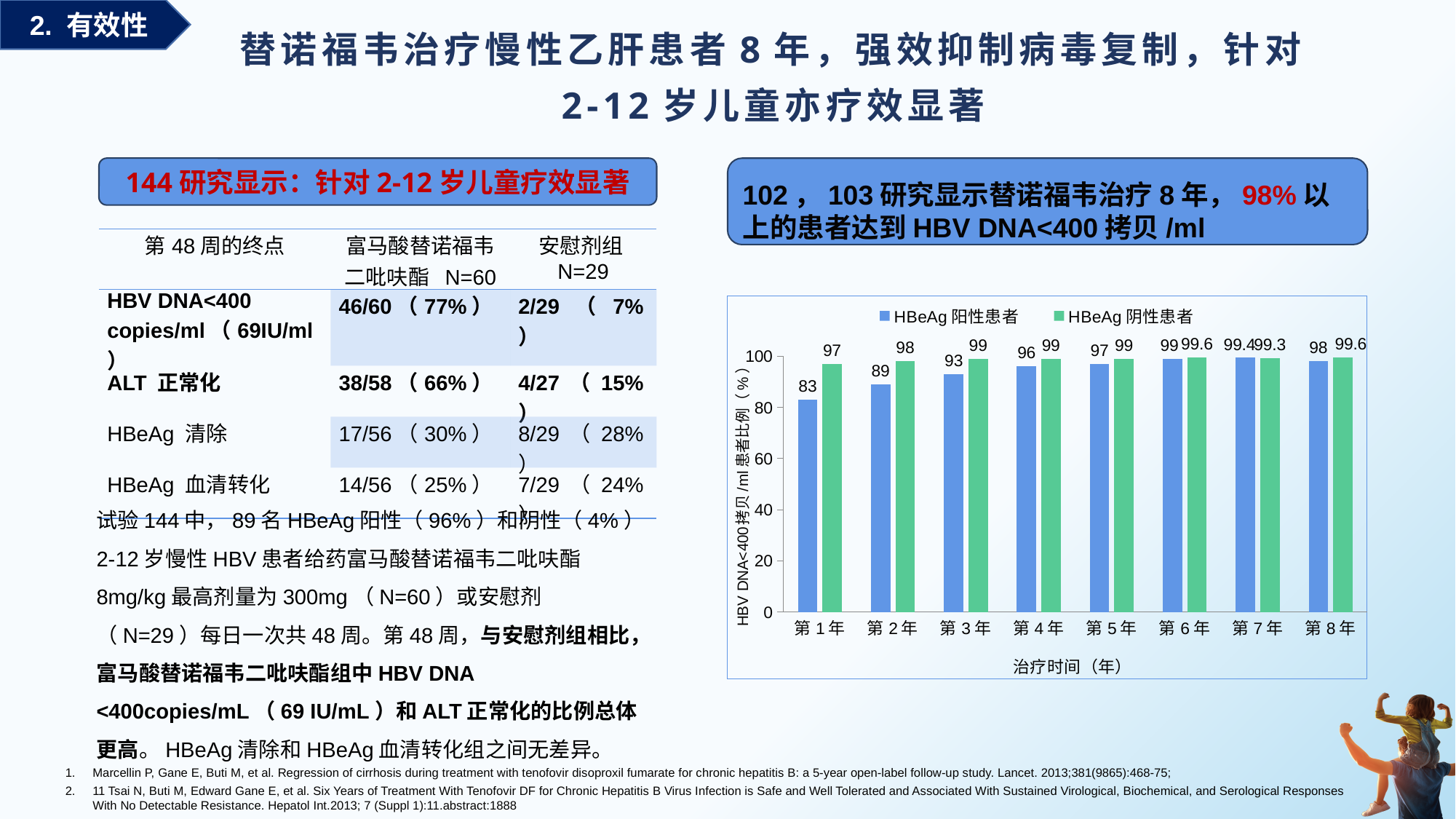
Does the value for HBeAg 阳性患者 generally rise or fall from 第1年 to 第7年? rise What colour are the bars for HBeAg 阴性患者 in the chart? green Which is larger in 第2年, HBeAg 阳性患者 or HBeAg 阴性患者? HBeAg 阴性患者 What type of chart is shown on the slide? bar chart What is the difference between HBeAg 阴性患者 and HBeAg 阳性患者 in 第1年? 14 What is the value for HBeAg 阳性患者 in 第7年? 99.4 What is the value for HBeAg 阴性患者 in 第6年? 99.6 In which year is the value for HBeAg 阳性患者 highest? 第7年 How many series does the chart legend list? 2 What is the value for HBeAg 阳性患者 in 第1年? 83 How many treatment-year categories are shown on the x axis of the chart? 8 In which year is the value for HBeAg 阳性患者 lowest? 第1年